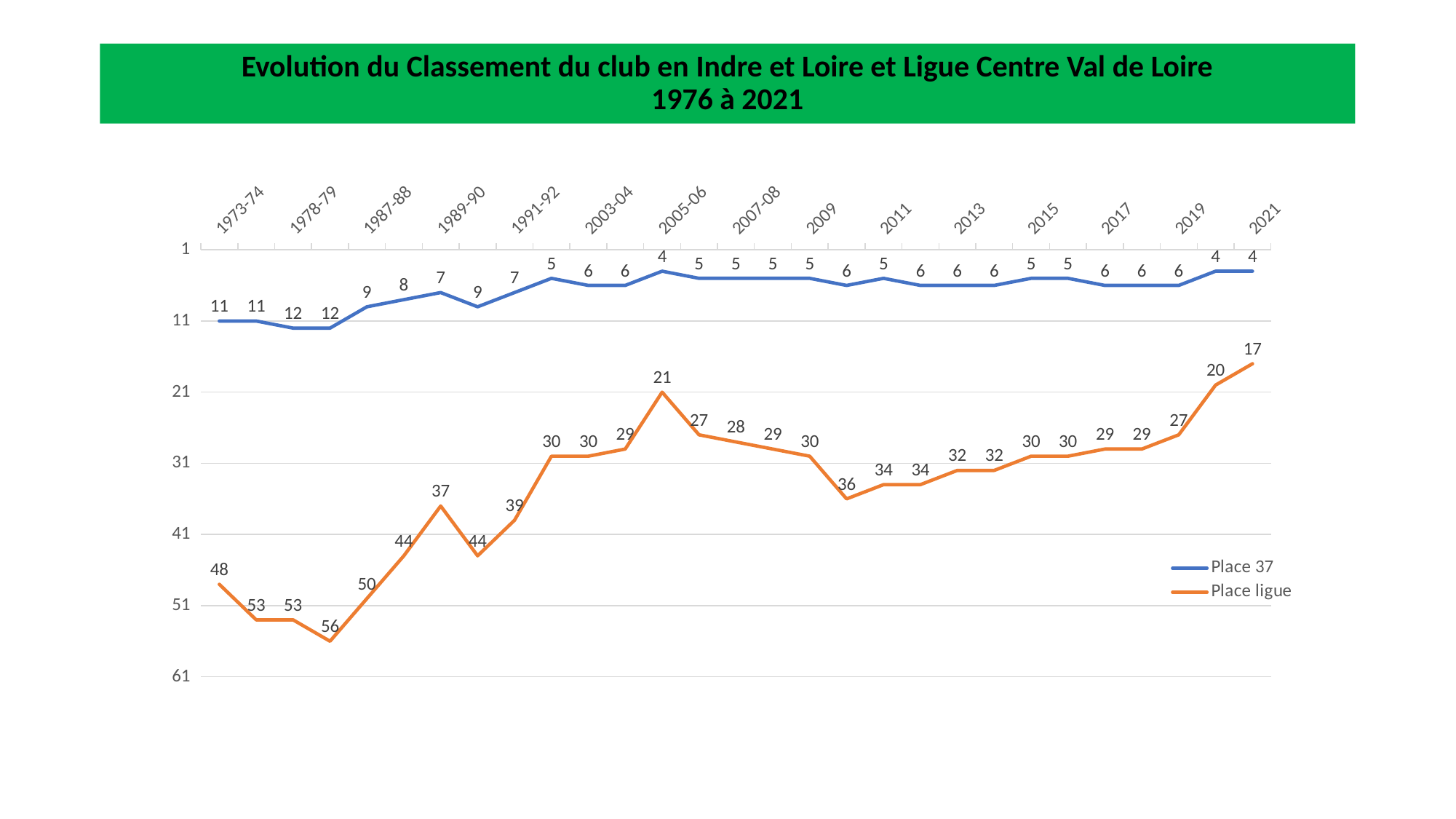
What type of chart is shown on the slide? line chart What is the difference between Place ligue and Place 37 in 2021? 13 What is the value of Place 37 for 1978-79? 12 Does the Place ligue series rise or fall between 2009 and 2021? fall What is the highest value plotted for the Place ligue series? 56 What is the value of Place 37 for 2021? 4 How many series does the legend list? 2 Which is larger, the Place ligue value for 1973-74 or for 2021? 1973-74 What is the value of Place ligue for 1973-74? 48 What is the value of Place ligue for 2005-06? 21 What colour is the line for the Place ligue series? orange What is the lowest value plotted for the Place ligue series? 17